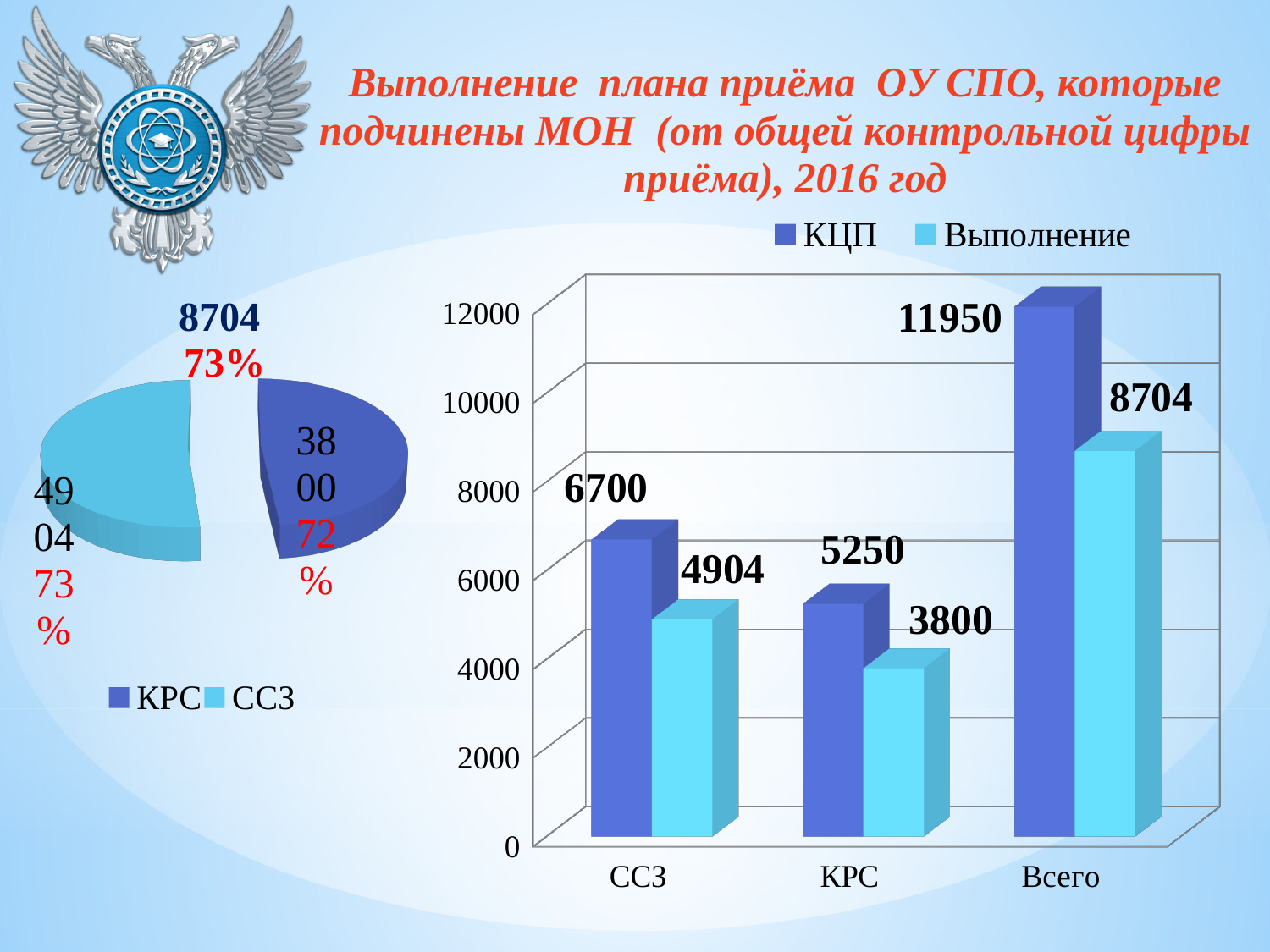
In the bar chart on the right, what is the difference between the КЦП and Выполнение values for КРС? 1450 In the pie chart on the left, what value is shown for the ССЗ slice? 4904 What kind of chart is on the left of the slide? Pie chart In the bar chart on the right, what is the difference between the КЦП and Выполнение values for ССЗ? 1796 In the bar chart on the right, which category has the lowest Выполнение value? КРС In the bar chart on the right, how many series does the legend list? 2 In the bar chart on the right, what is the КЦП value for Всего? 11950 In the bar chart on the right, what is the Выполнение value for Всего? 8704 In the bar chart on the right, what is the КЦП value for ССЗ? 6700 In the bar chart on the right, what is the Выполнение value for КРС? 3800 In the bar chart on the right, how many categories are shown on the x axis? 3 In the bar chart on the right, which is larger: the КЦП value for ССЗ or the КЦП value for КРС? КЦП for ССЗ